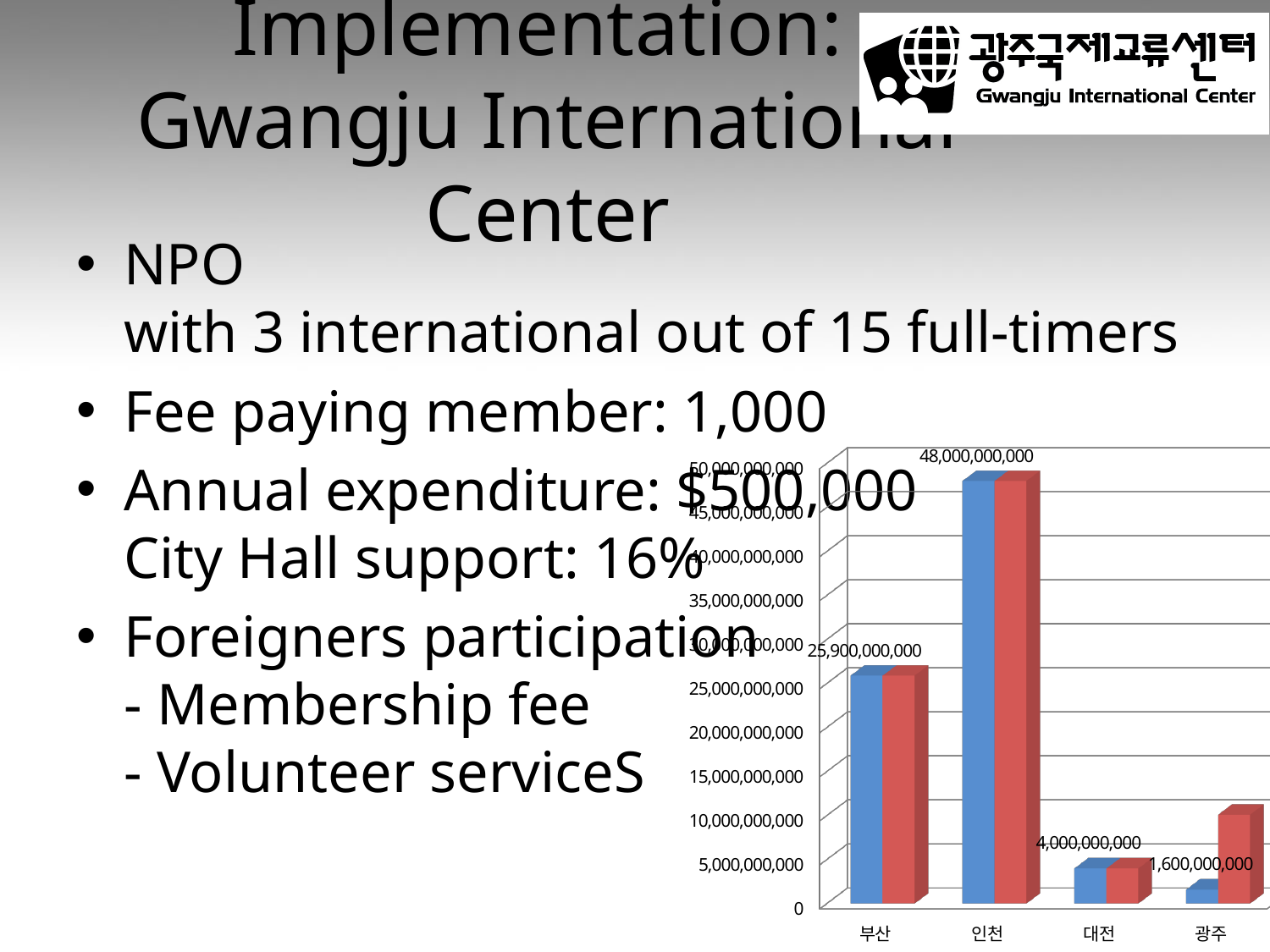
What value is labelled for 부산 in the chart? 25,900,000,000 What value is labelled for 광주 in the chart? 1,600,000,000 What is the highest value shown on the chart's vertical axis? 50,000,000,000 What kind of chart is shown on the slide? bar chart What is the difference between the labelled values for 인천 and 부산? 22,100,000,000 Which category has the lowest labelled value in the chart? 광주 Which has the larger labelled value, 부산 or 대전? 부산 Is the value of the red bar for 광주 greater or less than 5,000,000,000? greater What value is labelled for 인천 in the chart? 48,000,000,000 Which category has the highest labelled value in the chart? 인천 How many categories are shown on the x axis of the chart? 4 What value is labelled for 대전 in the chart? 4,000,000,000